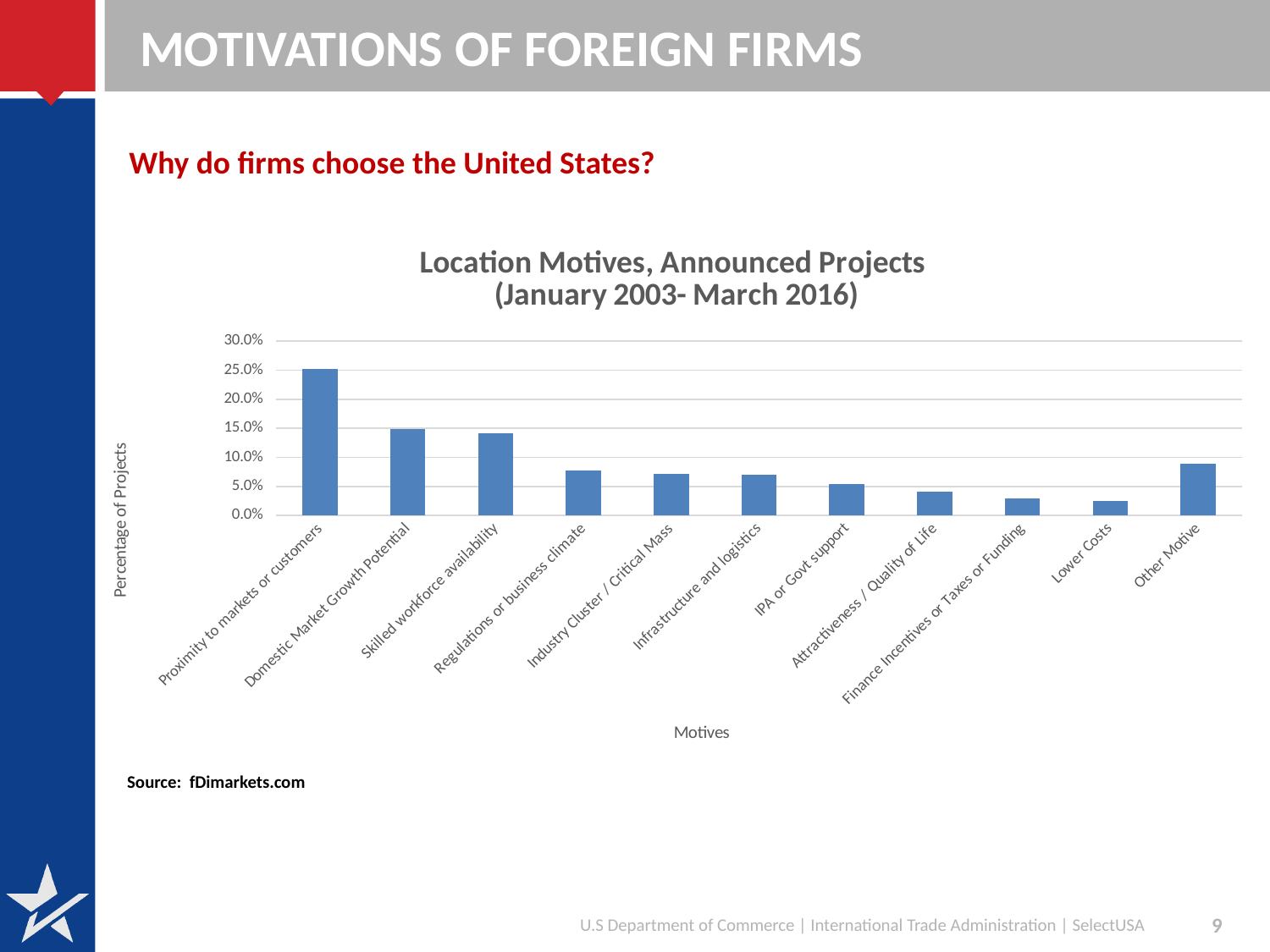
Is the value for Domestic Market Growth Potential greater or less than 20.0%? less Which is larger: the value for Other Motive or the value for Lower Costs? Other Motive Is the value for Lower Costs greater or less than 5.0%? less Which is larger: the value for Proximity to markets or customers or the value for Domestic Market Growth Potential? Proximity to markets or customers Is the value for Proximity to markets or customers greater or less than 20.0%? greater What kind of chart is shown on the slide? Bar chart What is the title of the chart? Location Motives, Announced Projects (January 2003- March 2016) Which motive has the highest percentage of projects? Proximity to markets or customers How many motive categories are plotted on the chart? 11 What is the label on the vertical axis of the chart? Percentage of Projects